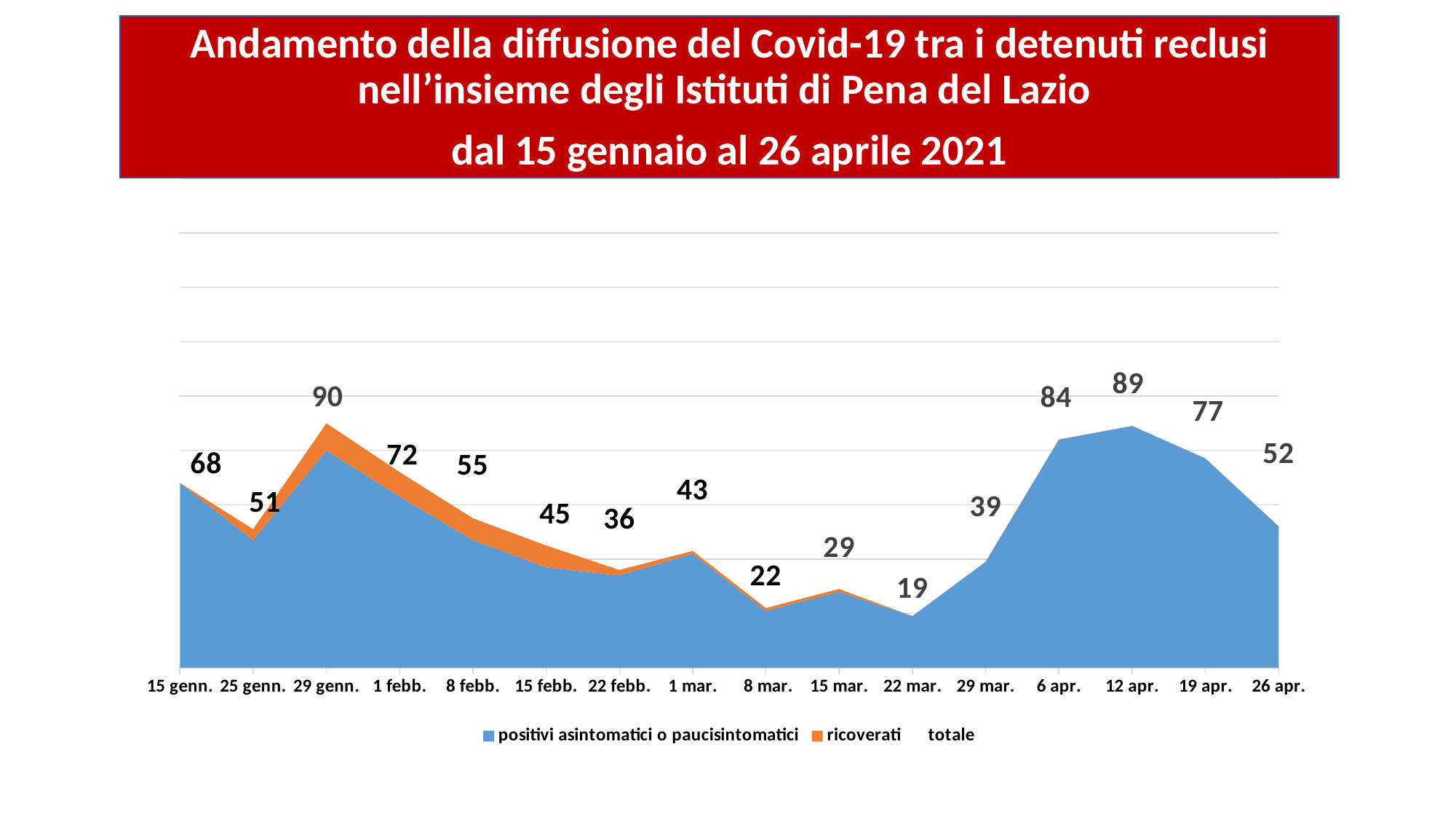
What is the difference between the labelled totals for 12 apr. and 6 apr.? 5 What is the total (totale) value labelled for 26 apr.? 52 What is the total (totale) value labelled for 29 genn.? 90 On which date is the labelled total highest? 29 genn. What is the difference between the highest labelled total (29 genn.) and the lowest (22 mar.)? 71 What is the total (totale) value labelled for 22 mar.? 19 How many dates are shown on the x axis? 16 How many series does the legend list? 3 What is the total (totale) value labelled for 12 apr.? 89 Which date has a larger labelled total, 6 apr. or 19 apr.? 6 apr. On which date is the labelled total lowest? 22 mar. Do the labelled totals rise or fall from 29 genn. to 22 febb.? fall